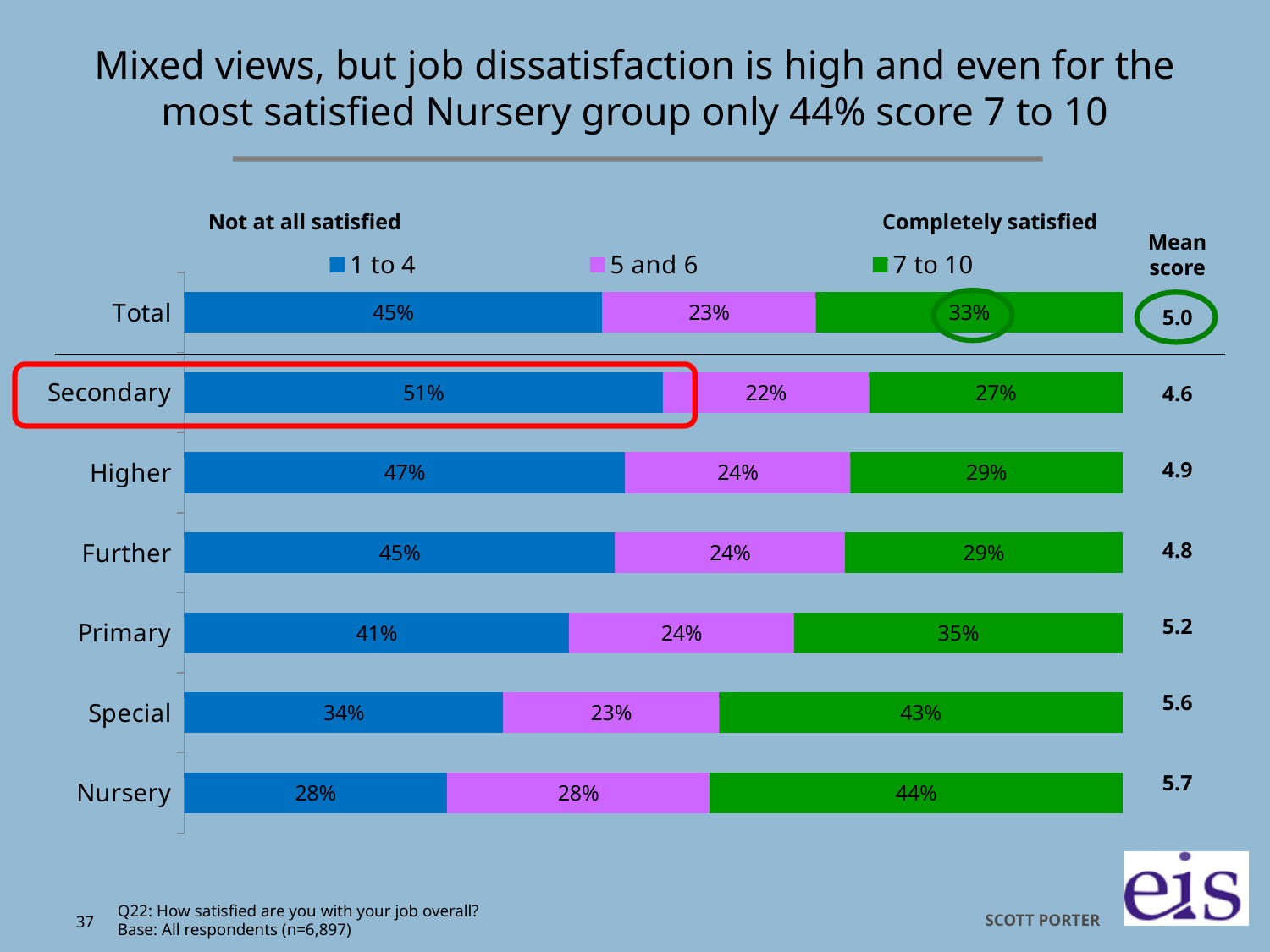
Which group has the highest percentage scoring 7 to 10? Nursery What kind of chart is shown on the slide? Stacked bar chart What percentage of Secondary respondents scored 1 to 4? 51% Which group has the lowest percentage scoring 1 to 4? Nursery What is the 5 and 6 value for Primary? 24% What is the difference between the 7 to 10 percentages for Special and Secondary? 16% Which colour represents the 7 to 10 series in the legend? Green What is the mean score shown for Special? 5.6 How many series does the legend list? 3 What percentage of Nursery respondents scored 7 to 10? 44% How many groups (bars) are shown in the chart, including Total? 7 Which is larger: the 1 to 4 percentage for Higher or for Primary? Higher